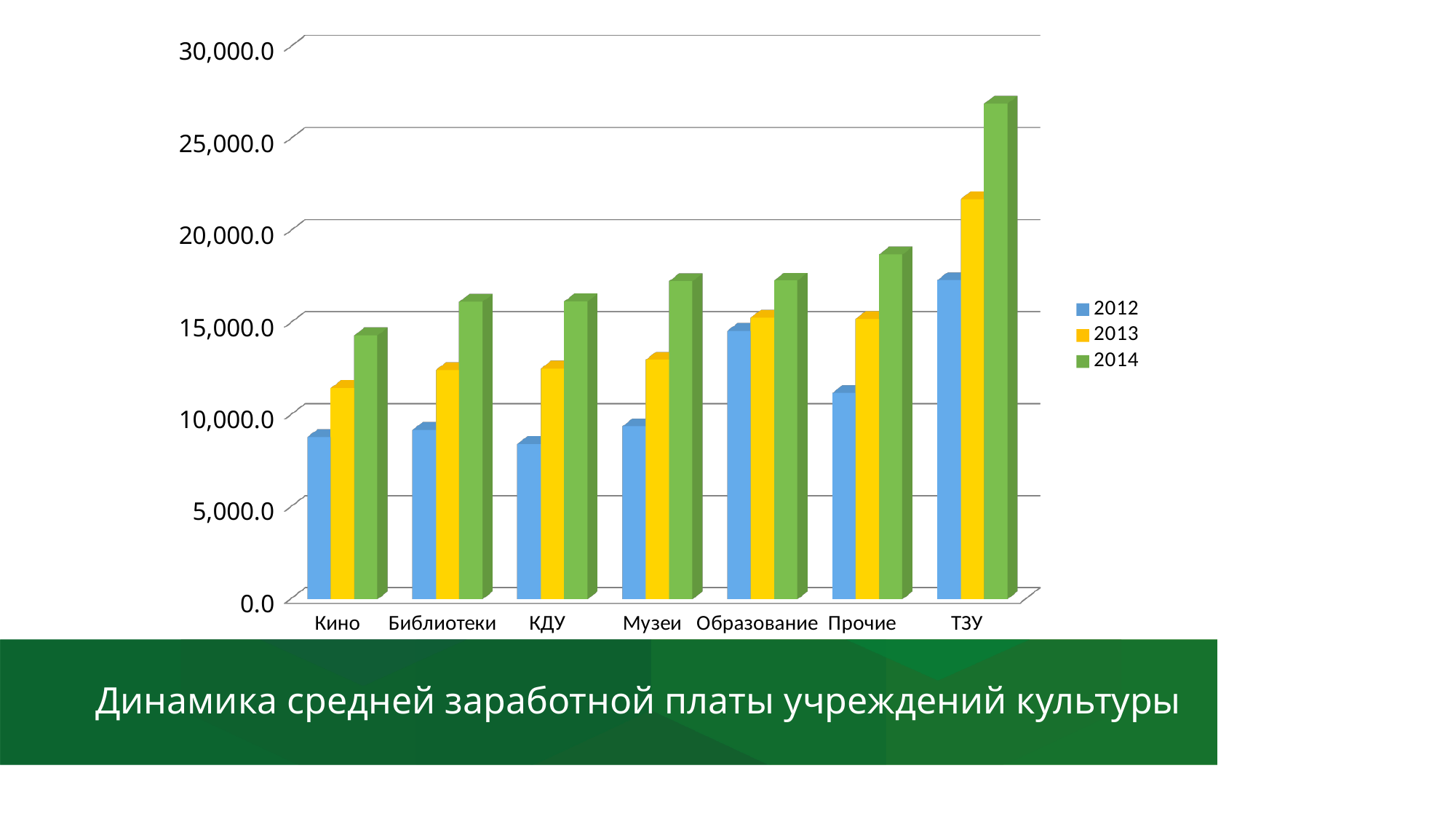
Is the 2014 value for ТЗУ greater or less than 25,000.0? greater Is the 2013 value for ТЗУ greater or less than 20,000.0? greater How many series does the legend list? 3 What is the title shown below the chart? Динамика средней заработной платы учреждений культуры What kind of chart is shown on the slide? bar chart Which category has the lowest value for the 2014 series? Кино For Кино, do the values rise or fall from 2012 to 2014? rise Which is larger: the 2012 value for ТЗУ or the 2012 value for Образование? ТЗУ Is the 2012 value for Кино greater or less than 10,000.0? less Which category has the highest value for the 2012 series? ТЗУ How many categories are shown on the x axis of the chart? 7 Which category has the highest value for the 2014 series? ТЗУ